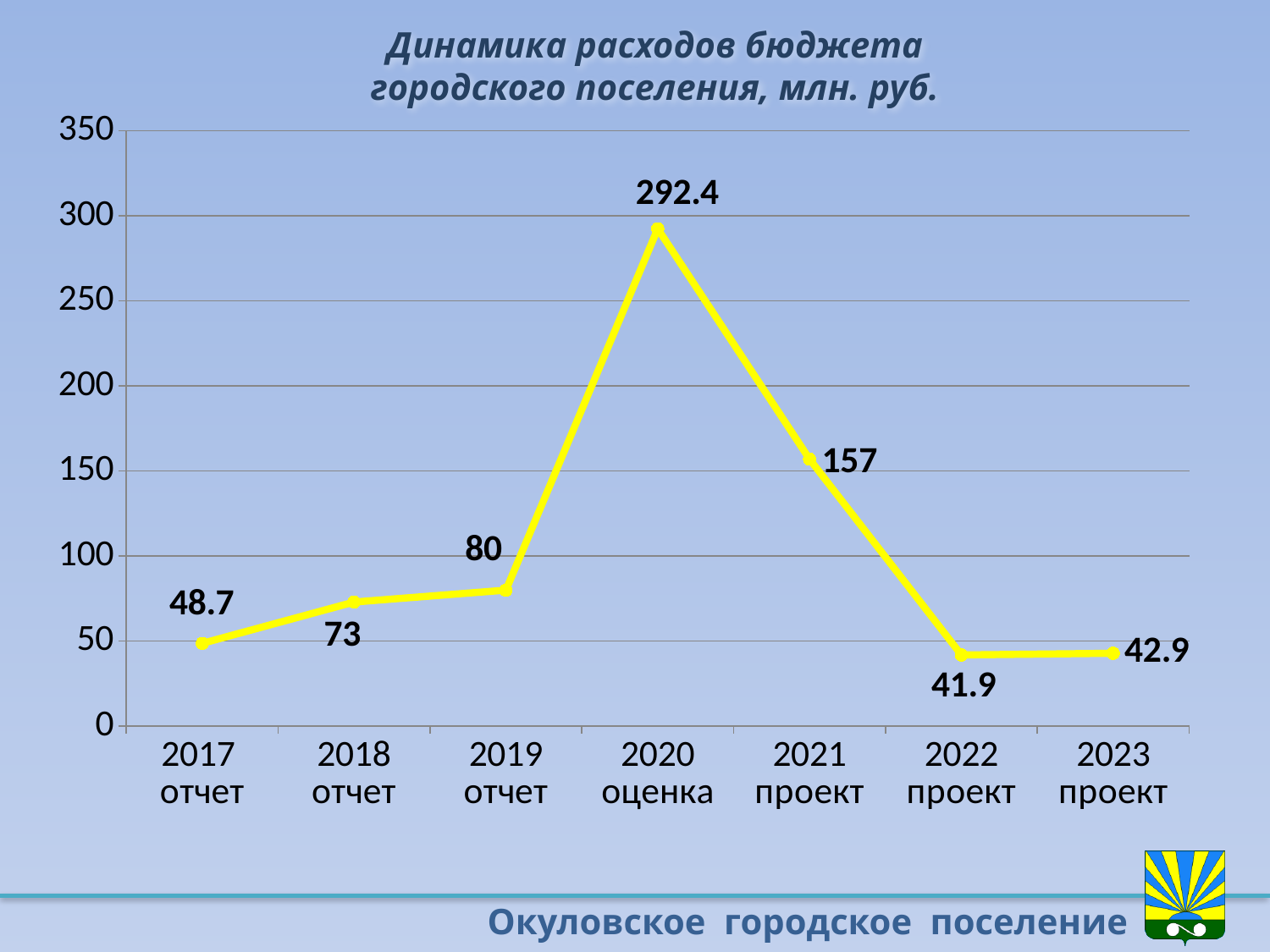
What is the value for 2020 оценка? 292.4 What is the difference between the values for 2020 оценка and 2021 проект? 135.4 Which year has the lowest value? 2022 проект Is the value for 2021 проект greater or less than 150? greater Which year has the highest value? 2020 оценка Do the values rise or fall from 2017 отчет to 2020 оценка? rise What is the difference between the values for 2019 отчет and 2018 отчет? 7 What is the value for 2022 проект? 41.9 What kind of chart is shown on the slide? line chart What is the value for 2017 отчет? 48.7 Which is larger, the value for 2021 проект or the value for 2019 отчет? 2021 проект How many years are plotted on the chart? 7